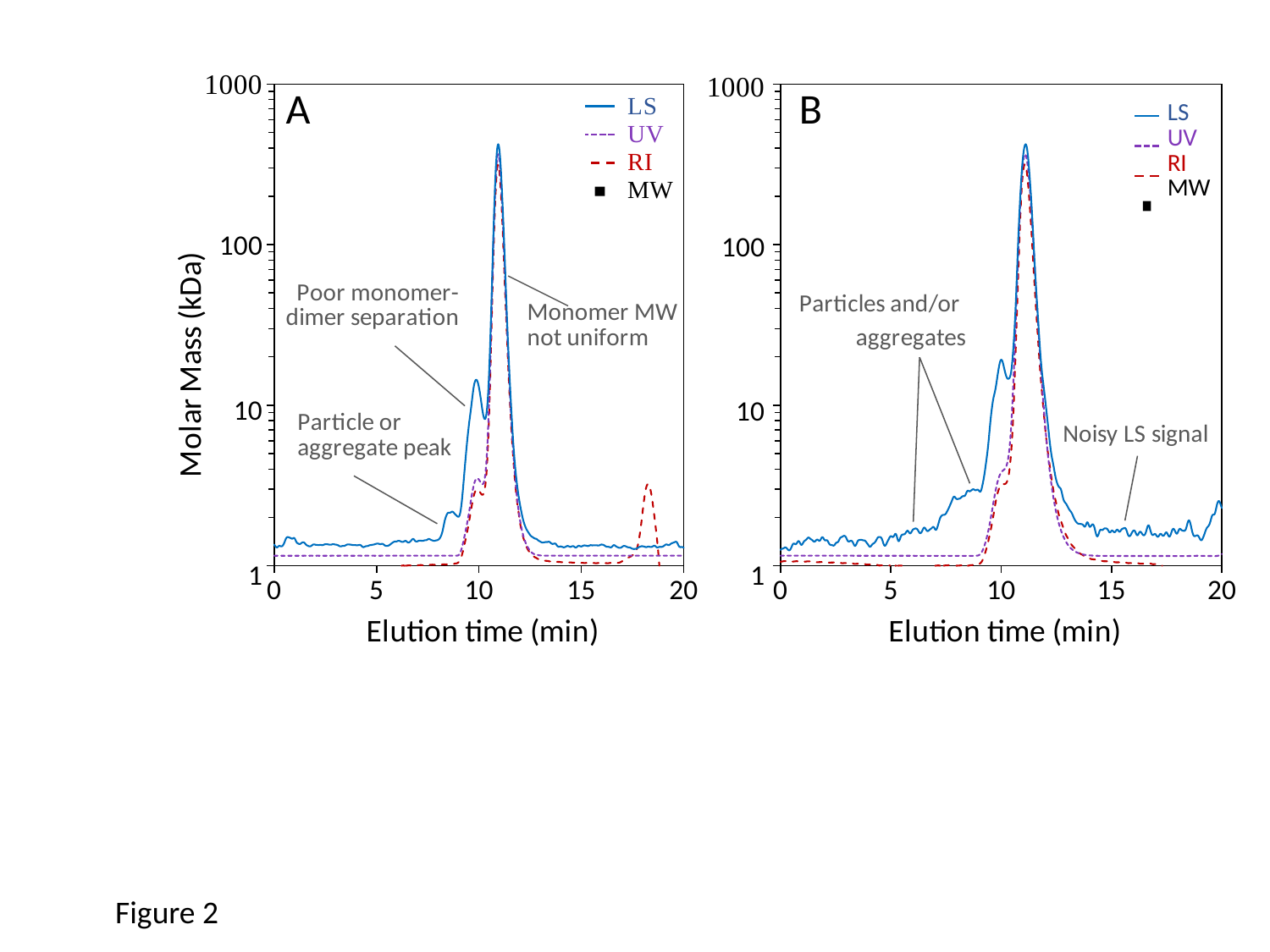
In chart A, is the LS value at 5 minutes greater or less than 10? less In chart B, is the LS value at 10 minutes greater or less than 10? greater In chart B, is the peak value of the RI series greater or less than 100? greater What is the y-axis label of chart A? Molar Mass (kDa) What type of chart is chart A? line chart How many series does the legend of chart B list? 4 What is the x-axis label of chart B? Elution time (min) How many series does the legend of chart A list? 4 What is the maximum value shown on the y-axis of chart B? 1000